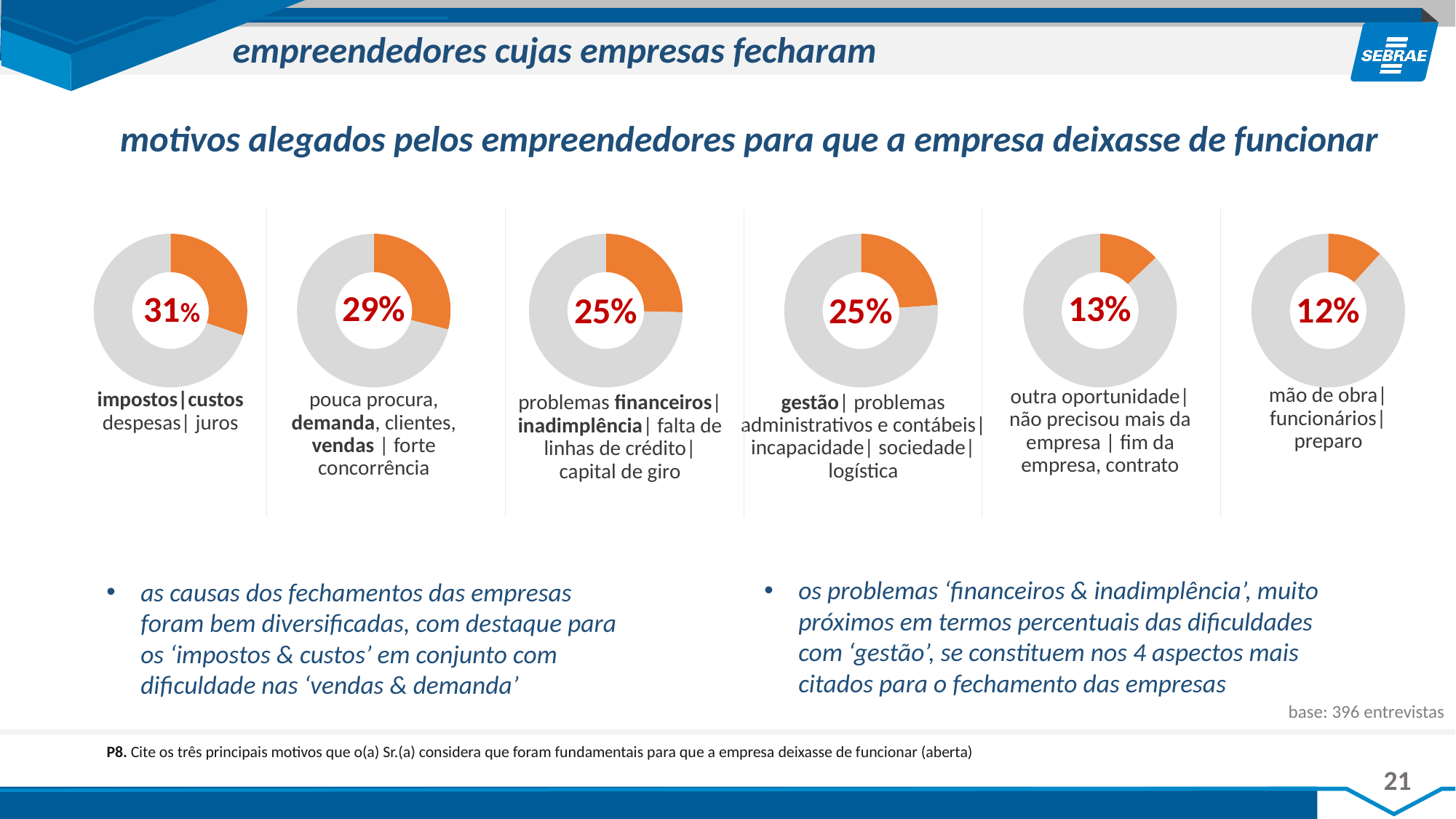
What percentage is shown in the donut chart labelled 'pouca procura, demanda, clientes, vendas'? 29% What is the difference in percentage points between the 'impostos|custos' chart and the 'pouca procura, demanda' chart? 2 percentage points Which reason has the highest percentage among the six donut charts? impostos|custos What percentage is shown in the donut chart labelled 'impostos|custos'? 31% How many donut charts are shown on the slide? 6 What type of chart is used to show each percentage on the slide? Donut (pie) chart What percentage is shown in the donut chart labelled 'mão de obra|funcionários|preparo'? 12% What percentage is shown in the donut chart labelled 'gestão'? 25% What percentage is shown in the donut chart labelled 'problemas financeiros|inadimplência'? 25% Which is larger: the percentage for 'outra oportunidade' or the percentage for 'mão de obra'? outra oportunidade Which reason has the lowest percentage among the six donut charts? mão de obra|funcionários|preparo What percentage is shown in the donut chart labelled 'outra oportunidade'? 13%